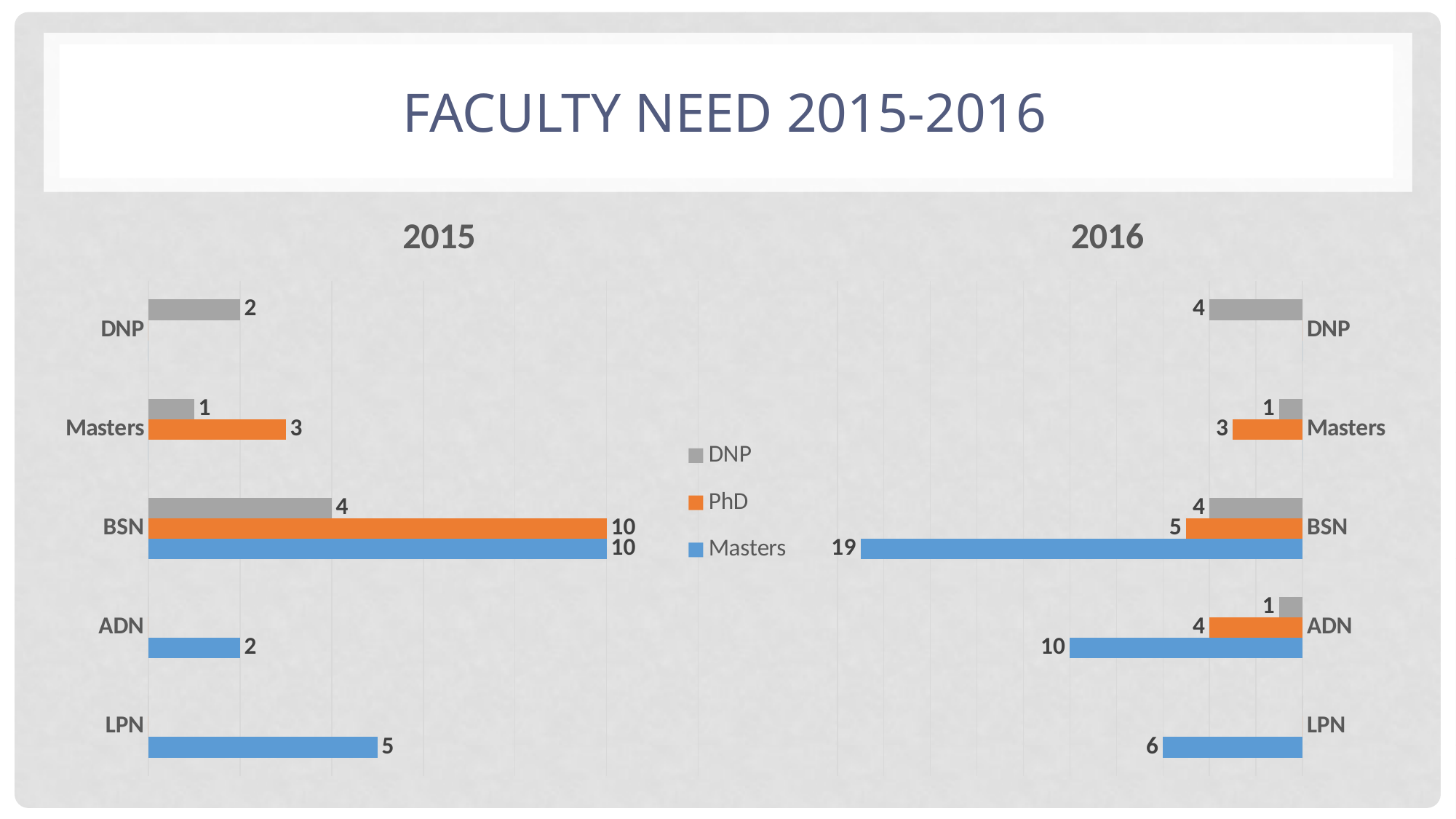
How many series does the legend list? 3 In the 2016 chart, what is the Masters value for LPN? 6 What type of chart is the 2015 chart? Bar chart In the 2015 chart, which is larger for BSN: the PhD value or the DNP value? PhD What is the difference between the Masters value for BSN in the 2016 chart and in the 2015 chart? 9 How many categories are shown in the 2016 chart? 5 In the 2015 chart, what is the DNP value for DNP? 2 In the 2016 chart, what is the PhD value for ADN? 4 In the 2016 chart, what is the Masters value for BSN? 19 In the 2016 chart, which category has the highest Masters value? BSN In the 2015 chart, what is the Masters value for BSN? 10